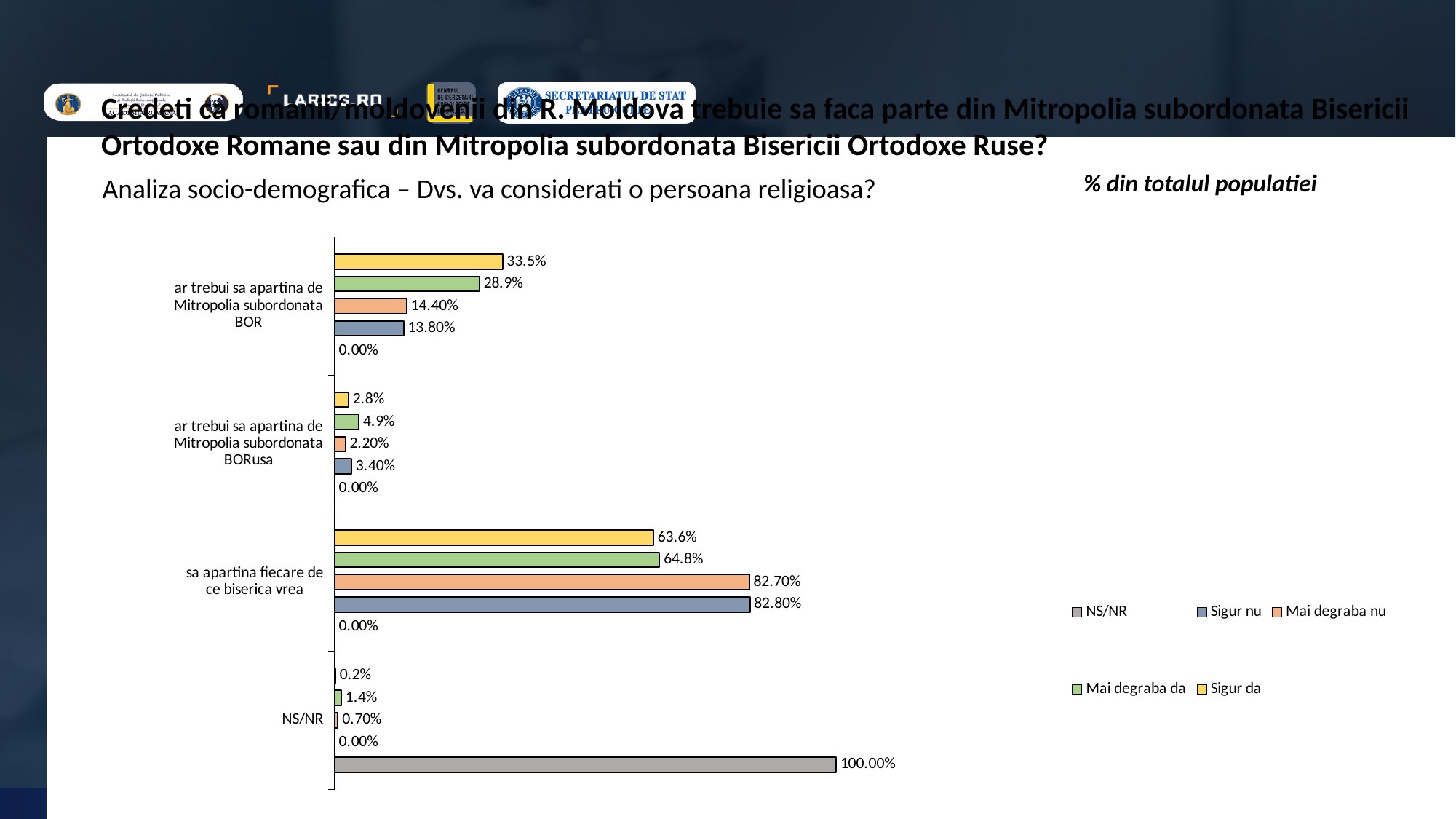
Which category has the highest value for the Sigur da series? sa apartina fiecare de ce biserica vrea How many series does the legend list? 5 What is the value of the Sigur da series for the category 'ar trebui sa apartina de Mitropolia subordonata BOR'? 33.5% Which category has the lowest value for the Mai degraba da series? NS/NR What is the difference between the Sigur da and Mai degraba da values for the category 'ar trebui sa apartina de Mitropolia subordonata BOR'? 4.6% What is the value of the Sigur nu series for the category 'ar trebui sa apartina de Mitropolia subordonata BORusa'? 3.40% What is the value of the Mai degraba nu series for the category 'sa apartina fiecare de ce biserica vrea'? 82.70% Which legend entry is shown in grey? NS/NR What is the value of the NS/NR series for the NS/NR category? 100.00% How many categories are shown on the vertical axis of the chart? 4 For the category 'sa apartina fiecare de ce biserica vrea', which is larger: the Sigur nu value or the Sigur da value? Sigur nu What kind of chart is shown on the slide? bar chart